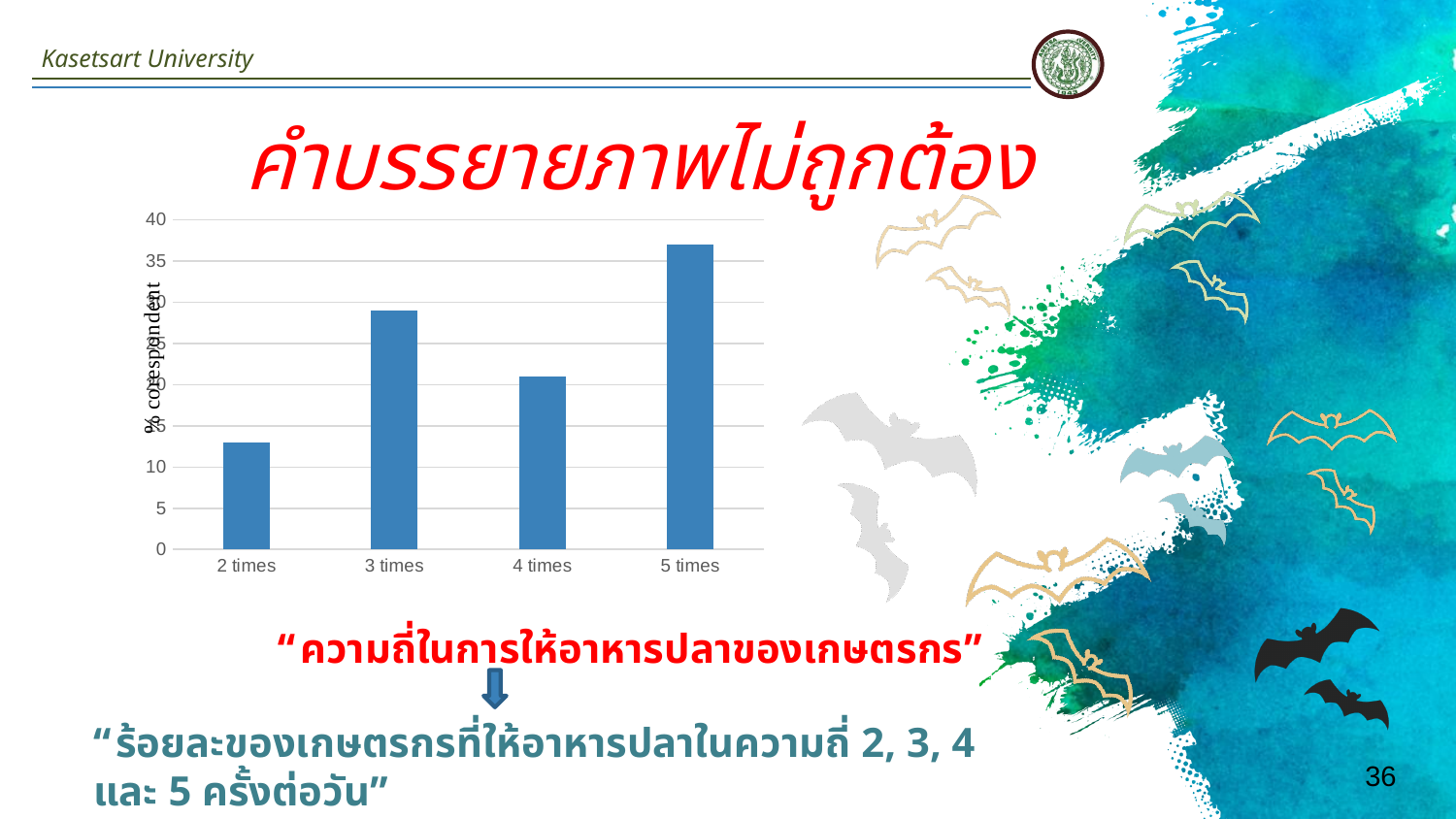
Is the value for 5 times greater or less than 35? greater What kind of chart is shown on the slide? bar chart What is the highest tick value shown on the y axis of the chart? 40 Which is larger, the value for 3 times or the value for 4 times? 3 times Is the value for 2 times greater or less than 15? less Is the value for 4 times greater or less than 25? less How many categories are shown on the x axis of the chart? 4 What is the label on the y axis of the chart? % correspondent Which category has the highest bar in the chart? 5 times Which is larger, the value for 2 times or the value for 5 times? 5 times Which category has the lowest bar in the chart? 2 times